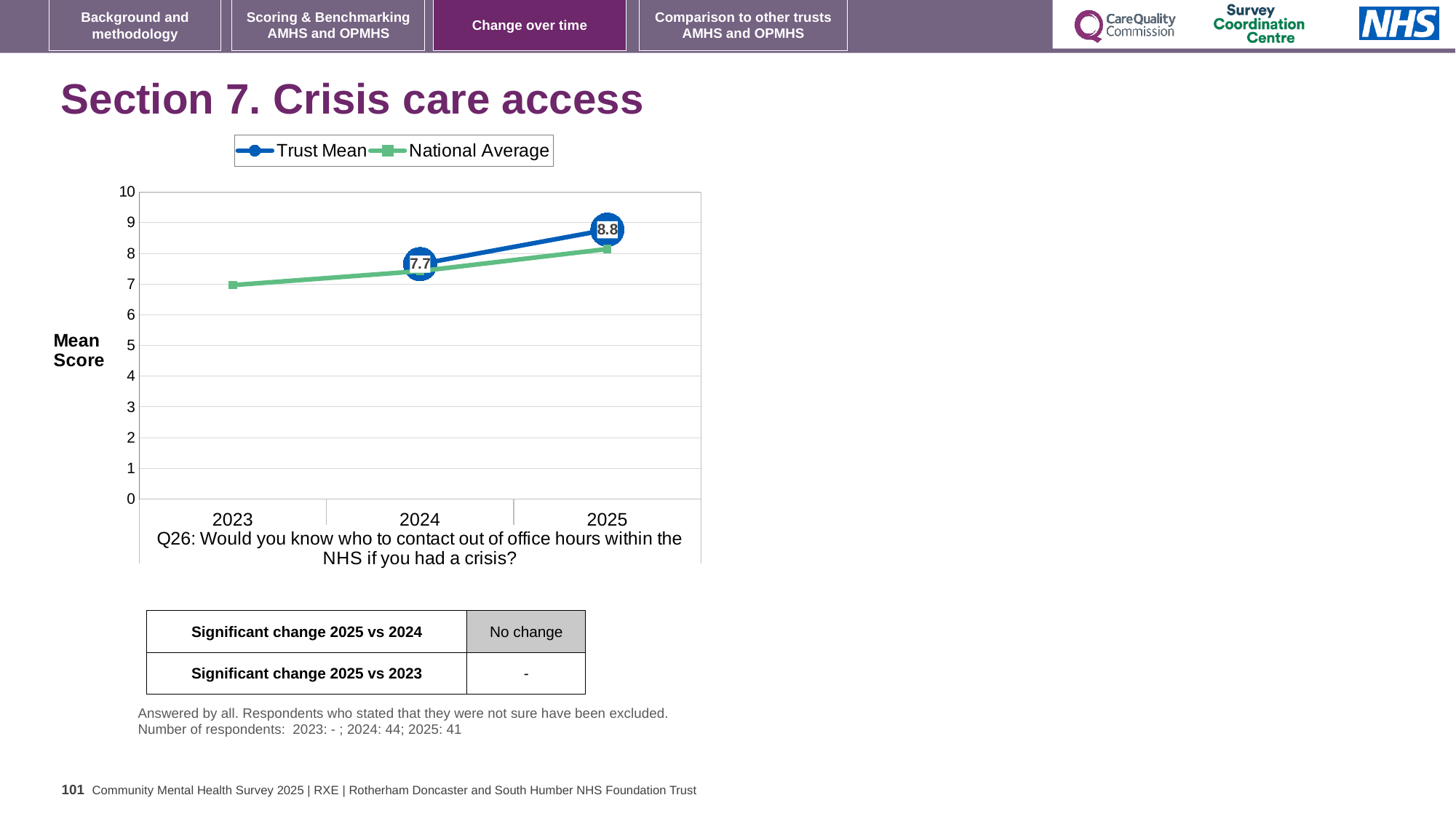
How many series does the legend list? 2 Does the Trust Mean rise or fall from 2024 to 2025? rise What kind of chart is shown on the slide? line chart Is the National Average value for 2023 greater or less than 8? less What is the Trust Mean value for 2024? 7.7 In 2025, which series has the higher value, Trust Mean or National Average? Trust Mean Is the National Average value for 2025 greater or less than 7? greater What is the Trust Mean value for 2025? 8.8 How many years are shown on the x axis? 3 Which year has the highest Trust Mean value? 2025 What is the label on the y axis of the chart? Mean Score What is the difference between the Trust Mean in 2025 and in 2024? 1.1